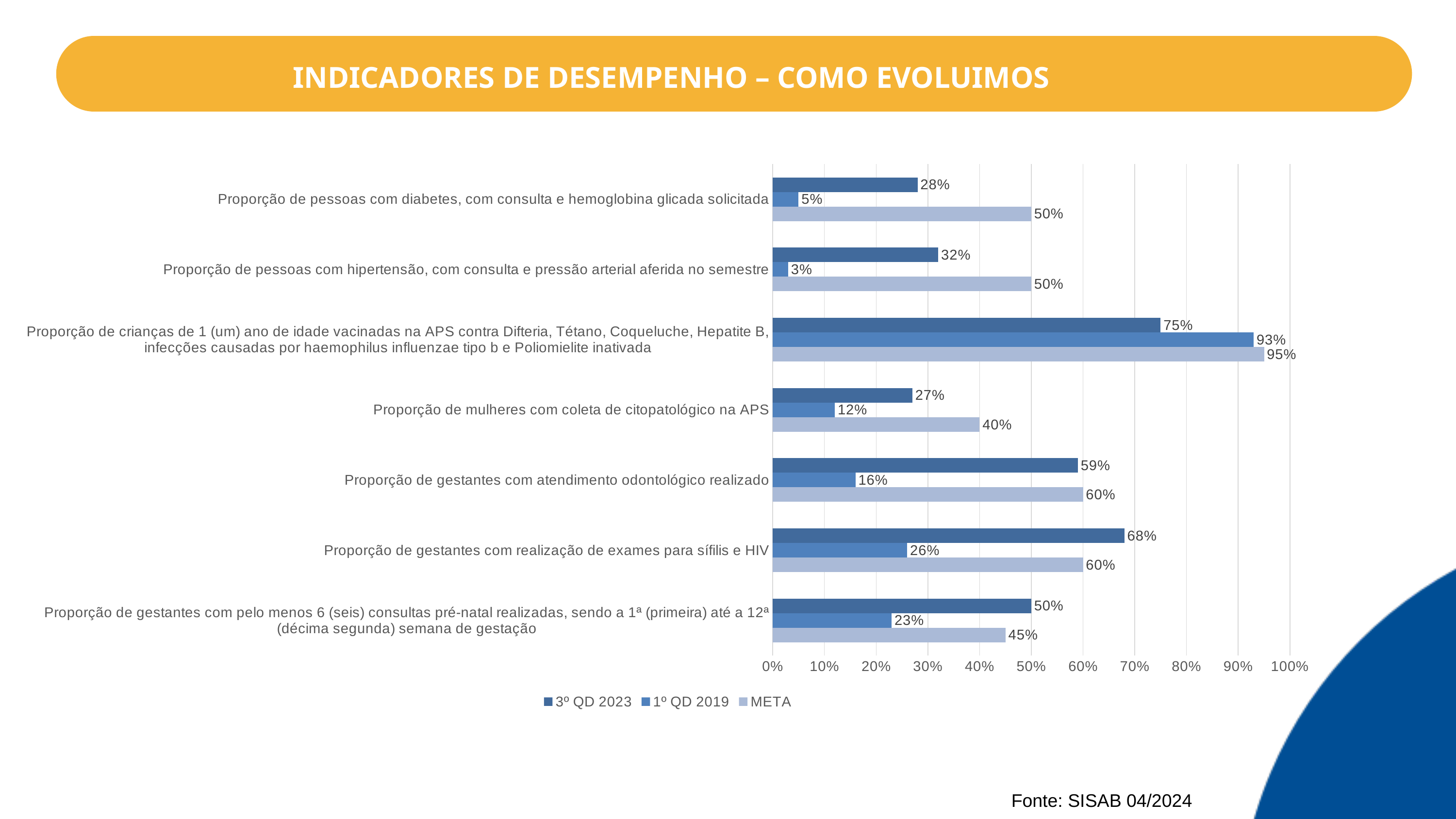
What is the 1º QD 2019 value for 'Proporção de pessoas com hipertensão, com consulta e pressão arterial aferida no semestre'? 3% What is the META value for 'Proporção de mulheres com coleta de citopatológico na APS'? 40% For 'Proporção de gestantes com realização de exames para sífilis e HIV', which is larger: the 3º QD 2023 value or the META value? 3º QD 2023 What is the 1º QD 2019 value for 'Proporção de gestantes com pelo menos 6 (seis) consultas pré-natal realizadas, sendo a 1ª (primeira) até a 12ª (décima segunda) semana de gestação'? 23% How many categories are shown on the chart? 7 How many series does the legend list? 3 What is the 3º QD 2023 value for 'Proporção de pessoas com diabetes, com consulta e hemoglobina glicada solicitada'? 28% Which category has the highest 3º QD 2023 value? Proporção de crianças de 1 (um) ano de idade vacinadas na APS contra Difteria, Tétano, Coqueluche, Hepatite B, infecções causadas por haemophilus influenzae tipo b e Poliomielite inativada What is the difference between the 3º QD 2023 and 1º QD 2019 values for 'Proporção de gestantes com atendimento odontológico realizado'? 43% What kind of chart is shown on the slide? Bar chart Which category has the lowest 1º QD 2019 value? Proporção de pessoas com hipertensão, com consulta e pressão arterial aferida no semestre What is the source cited at the bottom of the slide? Fonte: SISAB 04/2024